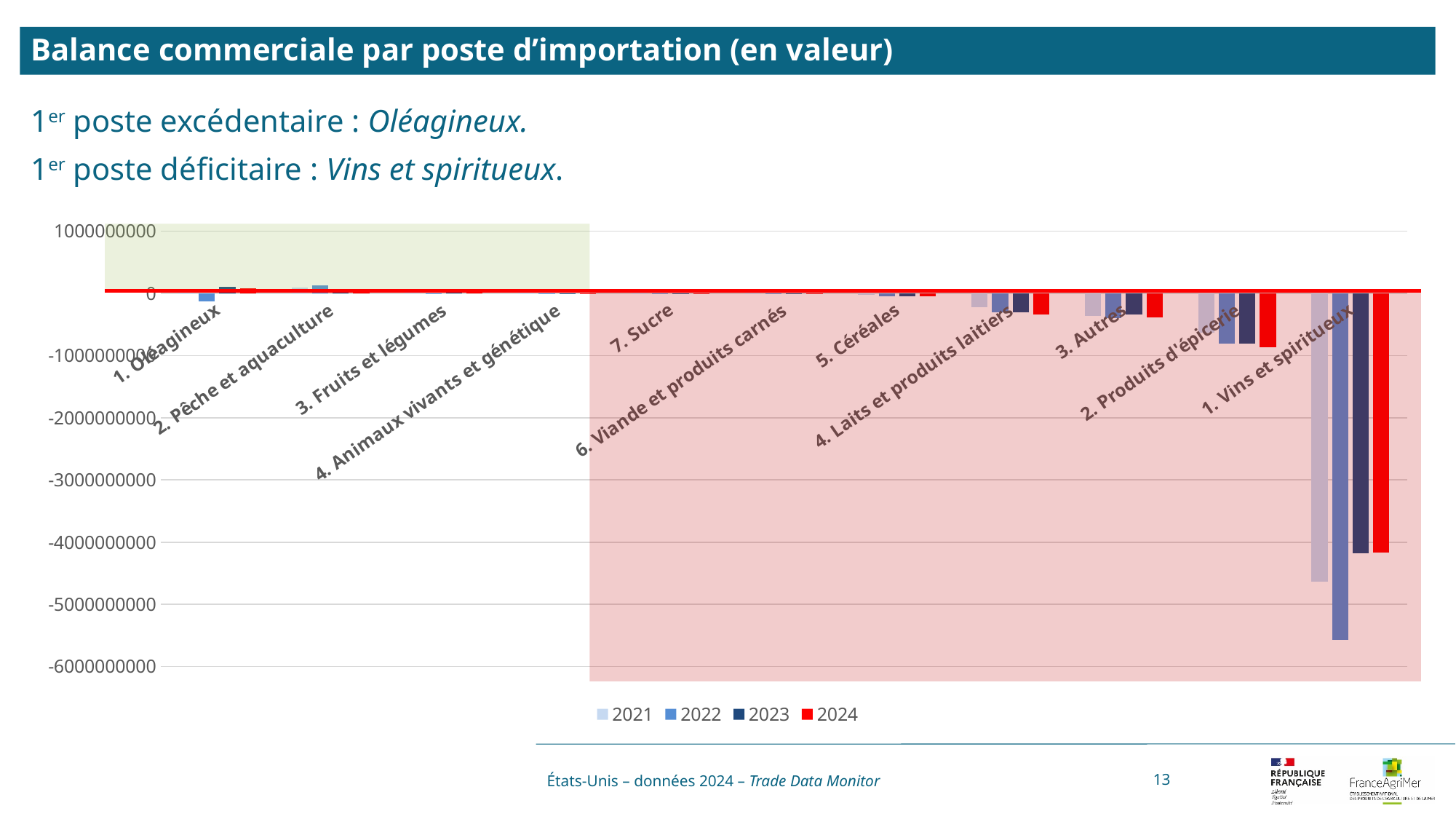
Which colour represents the 2024 series in the legend? red Which category has the lowest (most negative) values in the chart? 1. Vins et spiritueux How many series does the chart legend list? 4 Is the 2022 value for 1. Vins et spiritueux greater or less than -5000000000? less For 1. Vins et spiritueux, which is lower: the 2021 value or the 2022 value? 2022 How many categories are shown on the x axis of the chart? 11 Do the values generally rise or fall moving from left to right along the x axis? fall What kind of chart is shown on the slide? bar chart Which year shows the lowest value for 1. Vins et spiritueux? 2022 Is the 2024 value for 2. Produits d'épicerie greater or less than -1000000000? greater Is the 2024 value for 1. Vins et spiritueux greater or less than -4000000000? less In 2024, which category has the lower value: 3. Autres or 2. Produits d'épicerie? 2. Produits d'épicerie